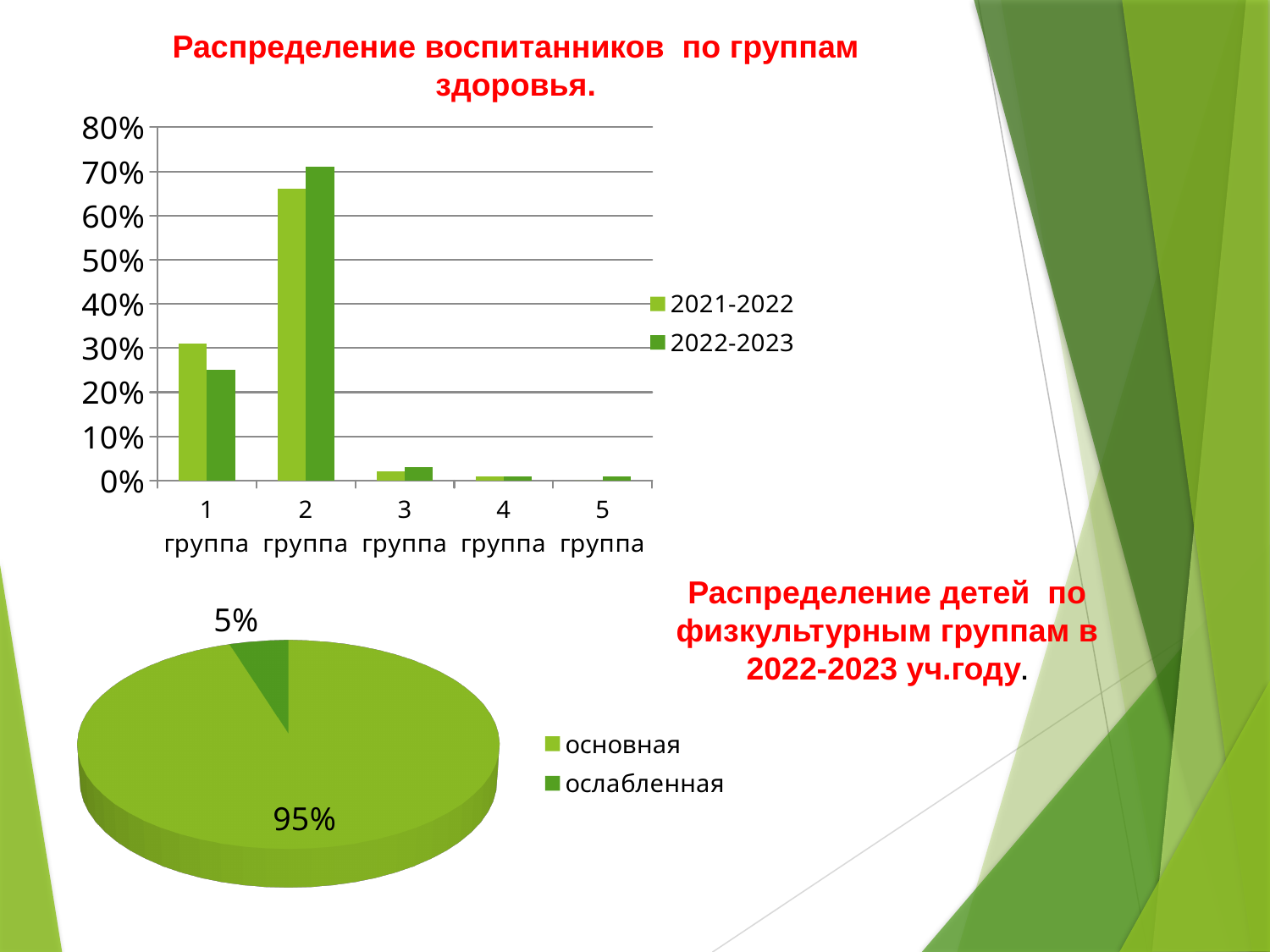
In the top bar chart "Распределение воспитанников по группам здоровья.", is the value for 1 группа in 2021-2022 greater or less than 40%? less In the top bar chart "Распределение воспитанников по группам здоровья.", which category has the highest value for 2021-2022? 2 группа In the top bar chart "Распределение воспитанников по группам здоровья.", how many series does the legend list? 2 In the top bar chart "Распределение воспитанников по группам здоровья.", for 2 группа, which series has the larger value: 2021-2022 or 2022-2023? 2022-2023 In the bottom pie chart "Распределение детей по физкультурным группам в 2022-2023 уч.году", what share is labelled for ослабленная? 5% In the bottom pie chart "Распределение детей по физкультурным группам в 2022-2023 уч.году", what share is labelled for основная? 95% In the top bar chart "Распределение воспитанников по группам здоровья.", how many categories are shown on the x axis? 5 In the top bar chart "Распределение воспитанников по группам здоровья.", is the value for 2 группа in 2022-2023 greater or less than 60%? greater What kind of chart is the bottom chart titled "Распределение детей по физкультурным группам в 2022-2023 уч.году"? pie chart In the top bar chart "Распределение воспитанников по группам здоровья.", for 1 группа, which series has the larger value: 2021-2022 or 2022-2023? 2021-2022 In the bottom pie chart "Распределение детей по физкультурным группам в 2022-2023 уч.году", what is the difference between the основная and ослабленная shares? 90% What kind of chart is the top chart titled "Распределение воспитанников по группам здоровья."? bar chart